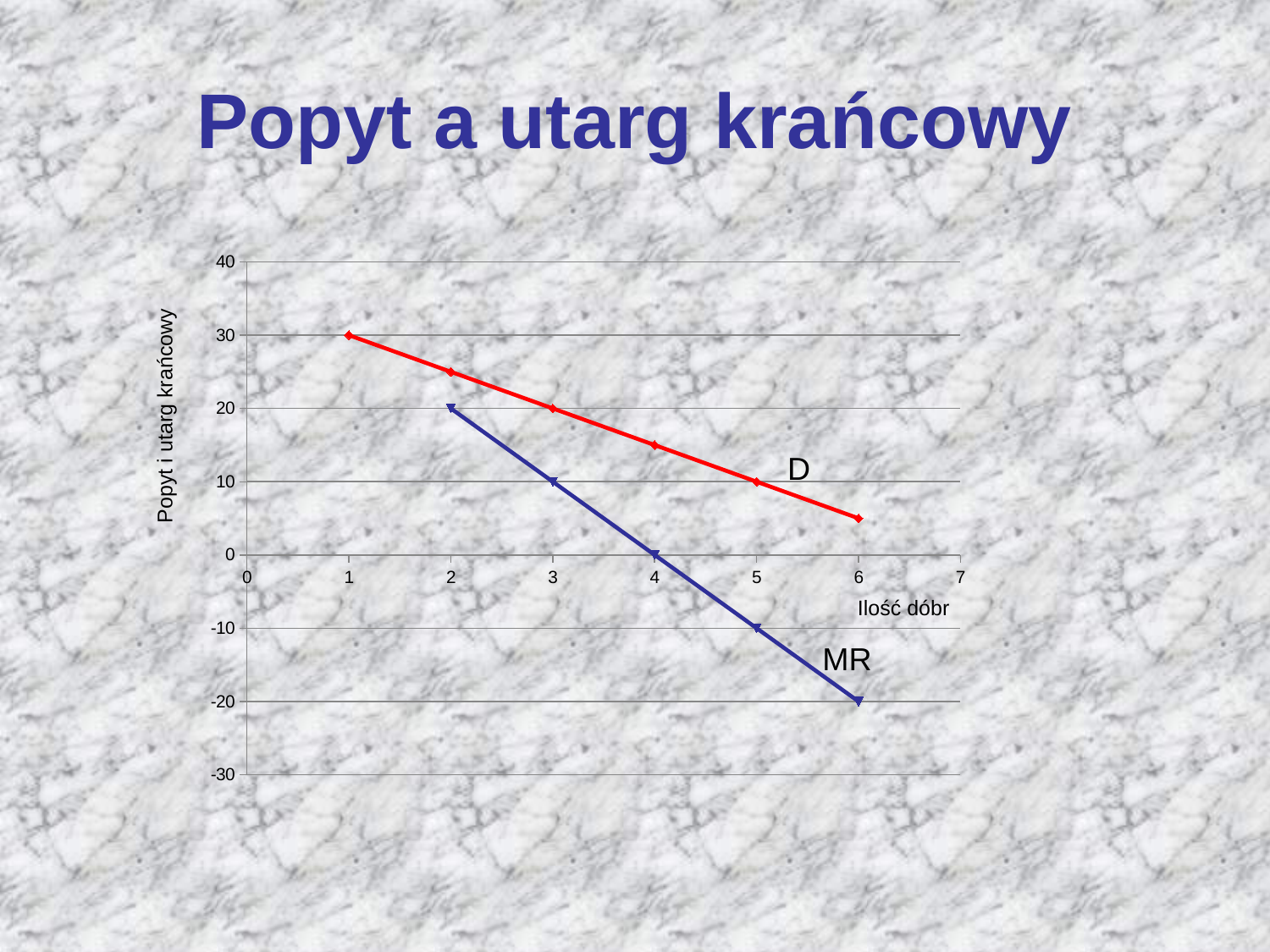
At quantity 5, which line has the larger value, D or MR? D At quantity 3, what is the difference between the D value and the MR value? 10 At which quantity does the MR line reach its lowest value? 6 What is the title of the x axis? Ilość dóbr What is the value of the D line at quantity 3? 20 What kind of chart is shown on the slide? line chart Do the values of the MR line rise or fall as quantity increases? fall Is the value of the D line at quantity 2 greater or less than 20? greater How many data points are plotted on the MR line? 5 What is the value of the D line at quantity 1? 30 What is the value of the MR line at quantity 6? -20 What is the value of the MR line at quantity 4? 0